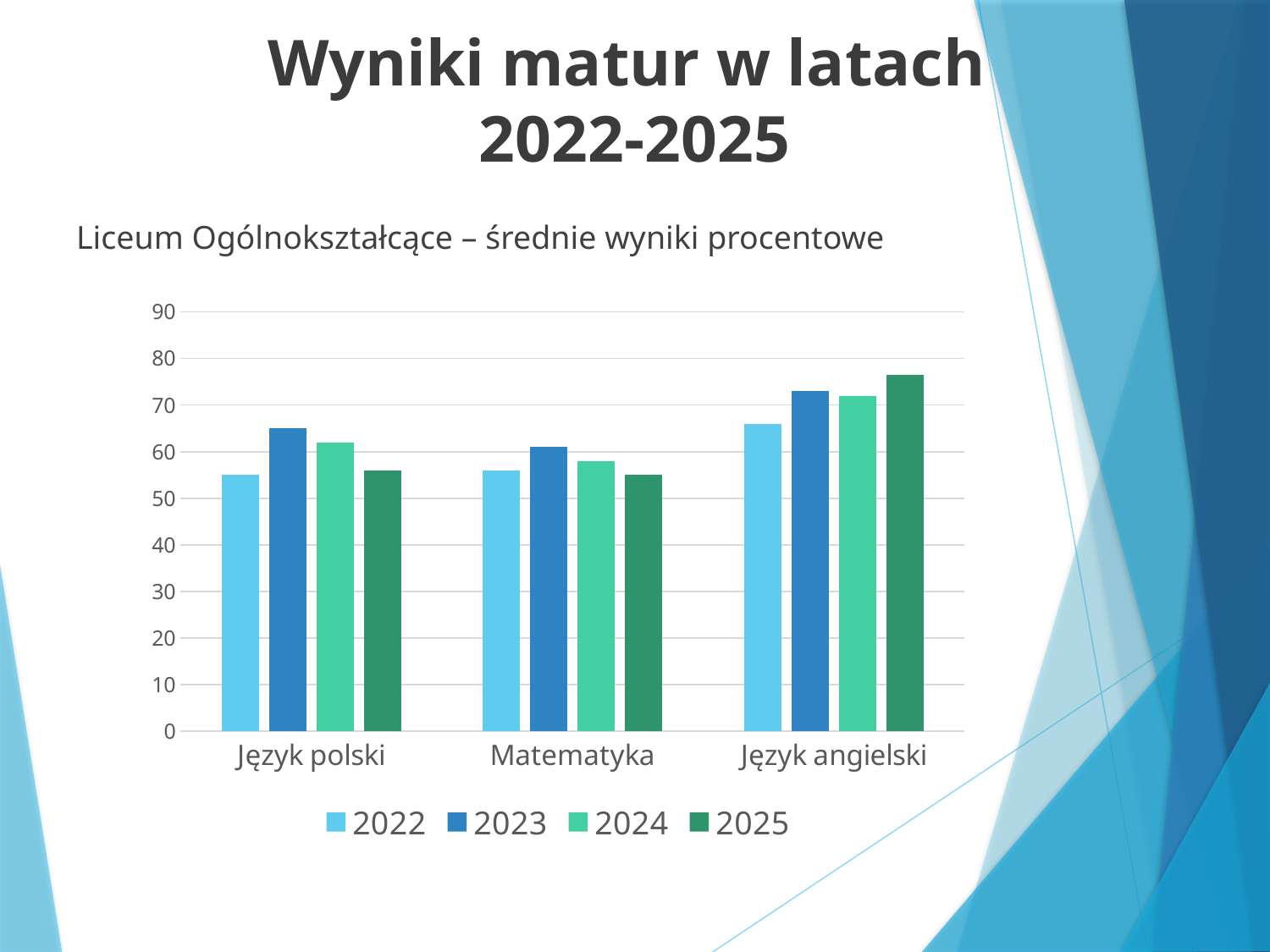
What is the subtitle text above the chart? Liceum Ogólnokształcące – średnie wyniki procentowe For Język angielski, which year has the lowest result? 2022 Which subject and year has the tallest bar in the chart? Język angielski, 2025 Is the value for Język angielski in 2025 greater or less than 70? greater For Język polski, which year has the highest result? 2023 For Matematyka, which year has the highest result? 2023 How many series does the legend list? 4 How many subject categories are shown on the x axis? 3 Which is larger: the 2023 value for Język angielski or the 2023 value for Język polski? Język angielski Is the value for Język polski in 2022 greater or less than 60? less What kind of chart is shown on the slide? bar chart Is the value for Matematyka in 2025 greater or less than 60? less